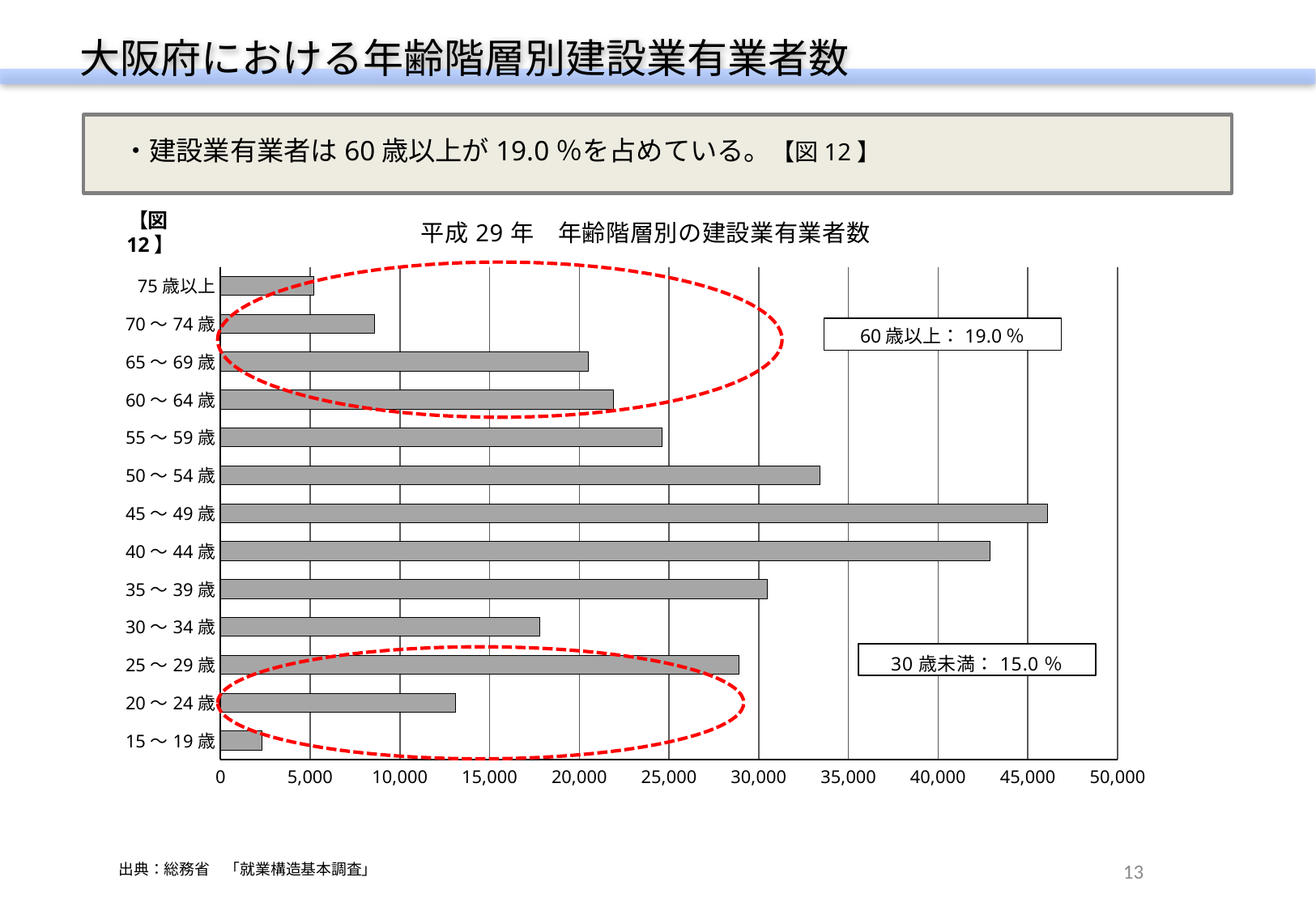
Which age category has the highest number of construction workers? 45～49歳 Is the value for 40～44歳 greater or less than 40,000? greater Is the value for 45～49歳 greater or less than 45,000? greater Which has more construction workers, 50～54歳 or 55～59歳? 50～54歳 Is the value for 20～24歳 greater or less than 10,000? greater What kind of chart is shown on the slide? bar chart According to the annotation on the chart, what share of construction workers are aged 60 and over? 19.0％ Which age category has the lowest number of construction workers? 15～19歳 How many age categories are plotted in the chart? 13 According to the annotation on the chart, what share of construction workers are under 30? 15.0％